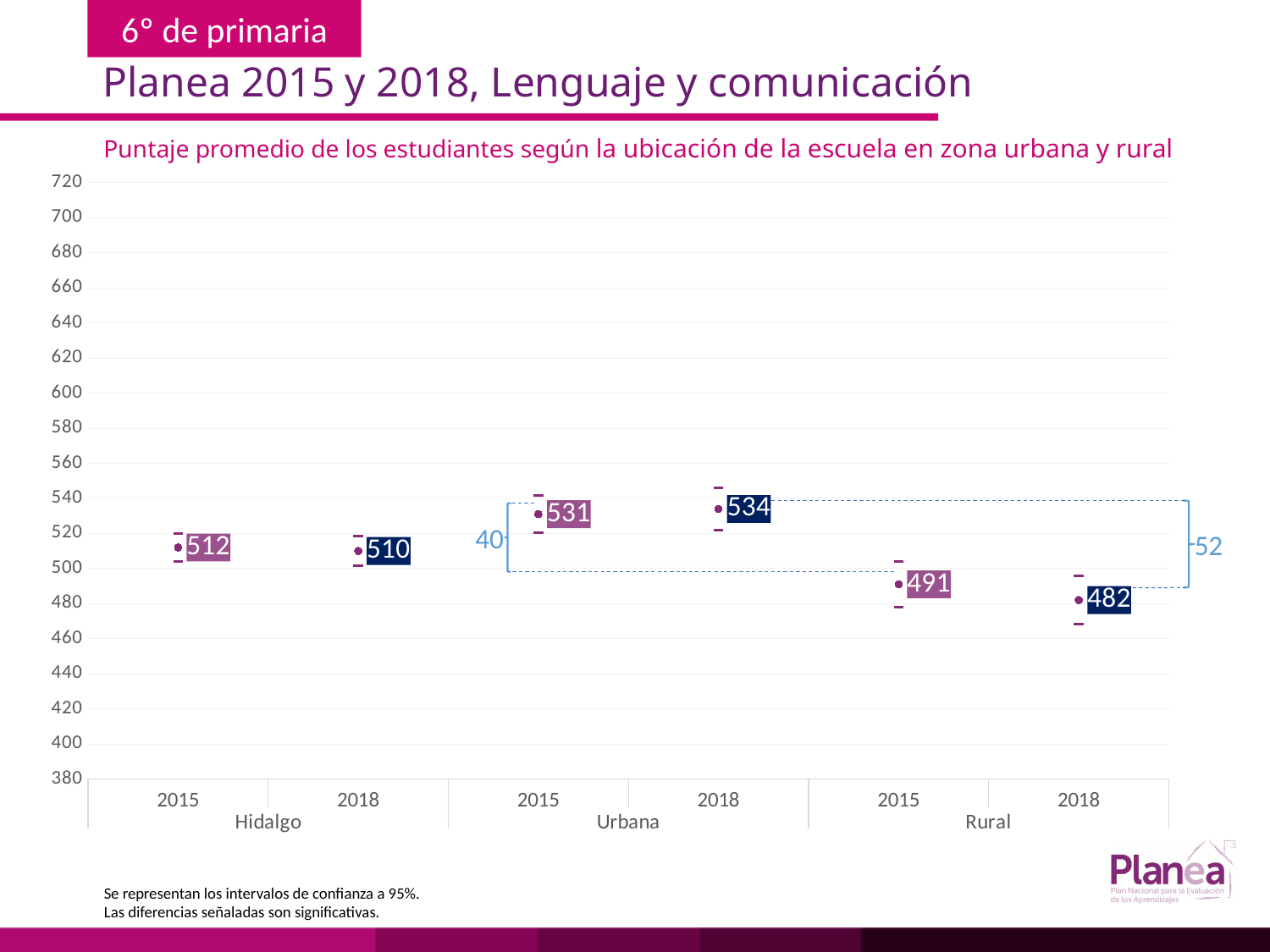
What is the difference between the Urbana and Rural average scores in 2018? 52 What is the average score for Rural in 2018? 482 What is the difference between the Urbana and Rural average scores in 2015? 40 Did the Rural average score rise or fall from 2015 to 2018? Fall What is the average score for Urbana in 2018? 534 What is the average score for Rural in 2015? 491 Which group and year has the highest average score? Urbana 2018 Which is larger, the Hidalgo score in 2015 or in 2018? 2015 Which group and year has the lowest average score? Rural 2018 What is the chart's subtitle describing the plotted data? Puntaje promedio de los estudiantes según la ubicación de la escuela en zona urbana y rural What is the average score for Hidalgo in 2015? 512 How many data points are plotted on the chart? 6